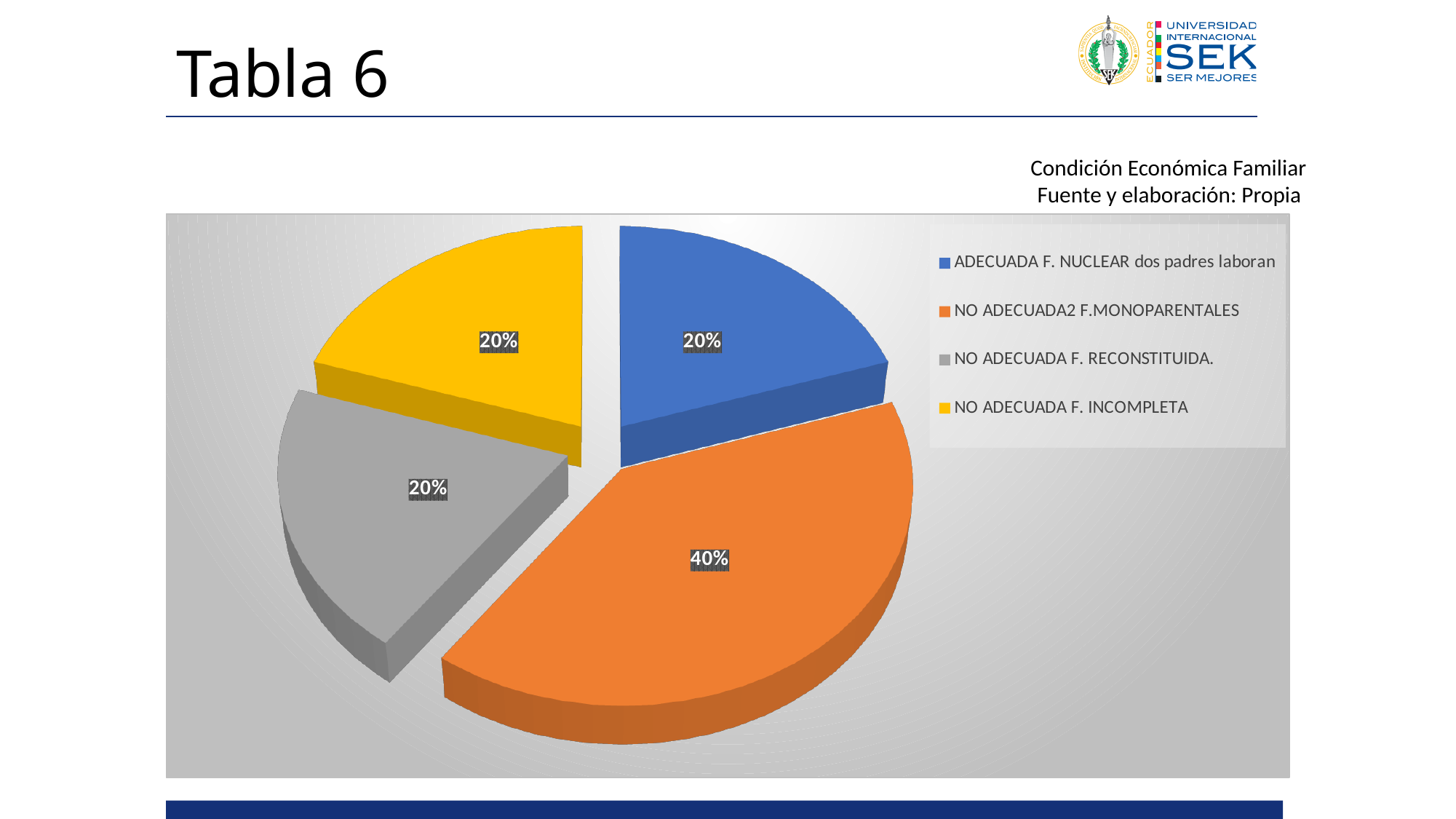
How many slices does the pie chart have? 4 Which is larger: the slice for NO ADECUADA2 F.MONOPARENTALES or the slice for ADECUADA F. NUCLEAR dos padres laboran? NO ADECUADA2 F.MONOPARENTALES What is the difference between the share for NO ADECUADA2 F.MONOPARENTALES and the share for NO ADECUADA F. INCOMPLETA? 20% What colour is the slice for NO ADECUADA F. INCOMPLETA? Yellow What is the title given above the chart? Condición Económica Familiar What share of the pie does NO ADECUADA F. RECONSTITUIDA. have? 20% What share of the pie does NO ADECUADA2 F.MONOPARENTALES have? 40% What kind of chart is shown on the slide? Pie chart What share of the pie does NO ADECUADA F. INCOMPLETA have? 20% How many entries does the legend list? 4 Which category has the largest slice of the pie? NO ADECUADA2 F.MONOPARENTALES